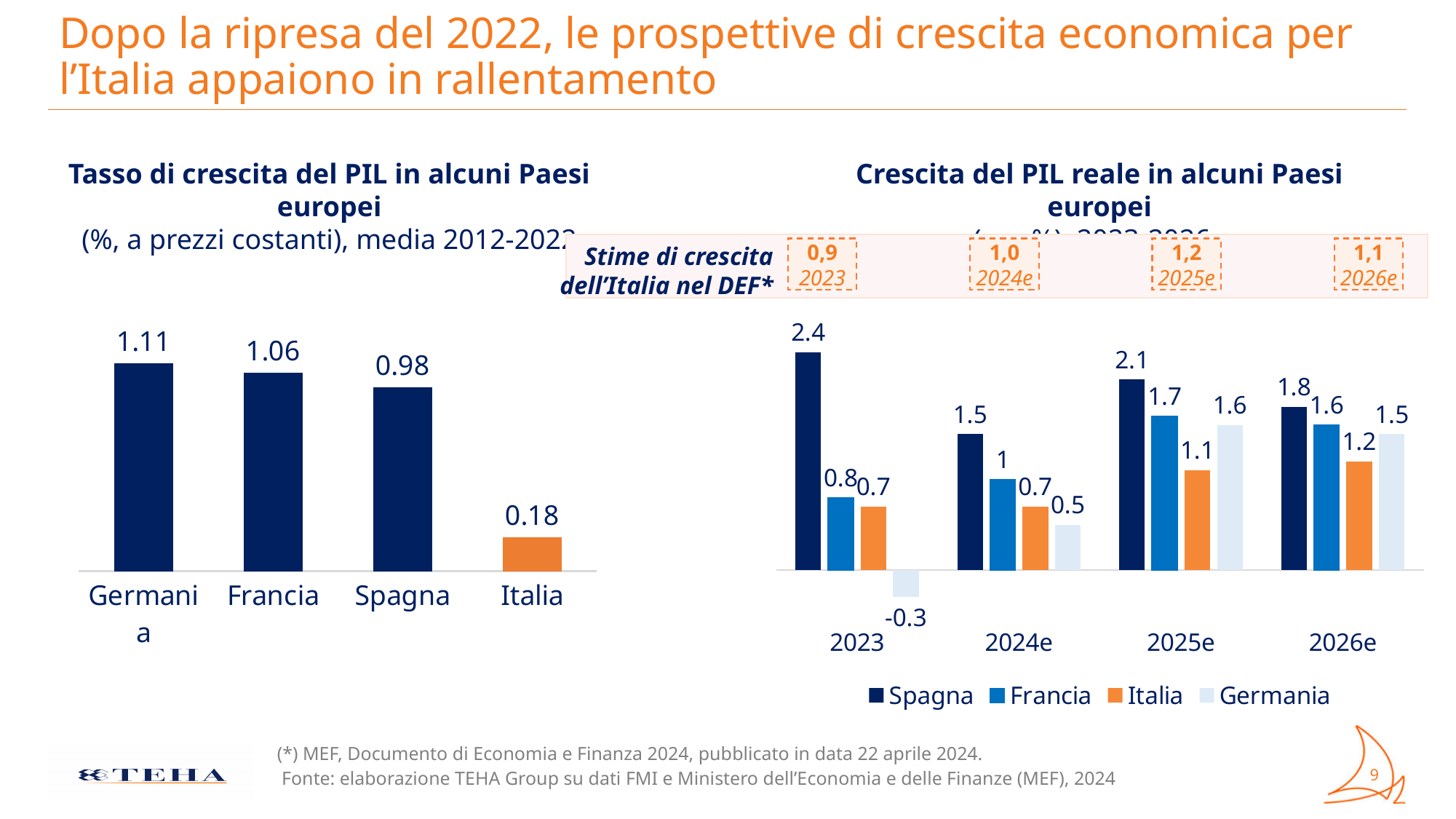
In the right chart (Crescita del PIL reale in alcuni Paesi europei), what is the value for Italia in 2026e? 1.2 In the right chart (Crescita del PIL reale in alcuni Paesi europei), what is the value for Spagna in 2023? 2.4 In the right chart (Crescita del PIL reale in alcuni Paesi europei), what is the difference between Spagna and Italia in 2025e? 1.0 In the left chart (Tasso di crescita del PIL in alcuni Paesi europei), what is the difference between Germania and Italia? 0.93 In the right chart (Crescita del PIL reale in alcuni Paesi europei), what is the value for Germania in 2023? -0.3 In the left chart (Tasso di crescita del PIL in alcuni Paesi europei), which country has the highest value? Germania In the left chart (Tasso di crescita del PIL in alcuni Paesi europei), how many countries are shown? 4 In the right chart (Crescita del PIL reale in alcuni Paesi europei), how many series does the legend list? 4 In the right chart (Crescita del PIL reale in alcuni Paesi europei), does the value for Italia rise or fall from 2024e to 2026e? rise In the left chart (Tasso di crescita del PIL in alcuni Paesi europei), what is the value for Italia? 0.18 In the right chart (Crescita del PIL reale in alcuni Paesi europei), which is larger in 2025e: Francia or Germania? Francia What kind of chart is the left chart (Tasso di crescita del PIL in alcuni Paesi europei)? bar chart